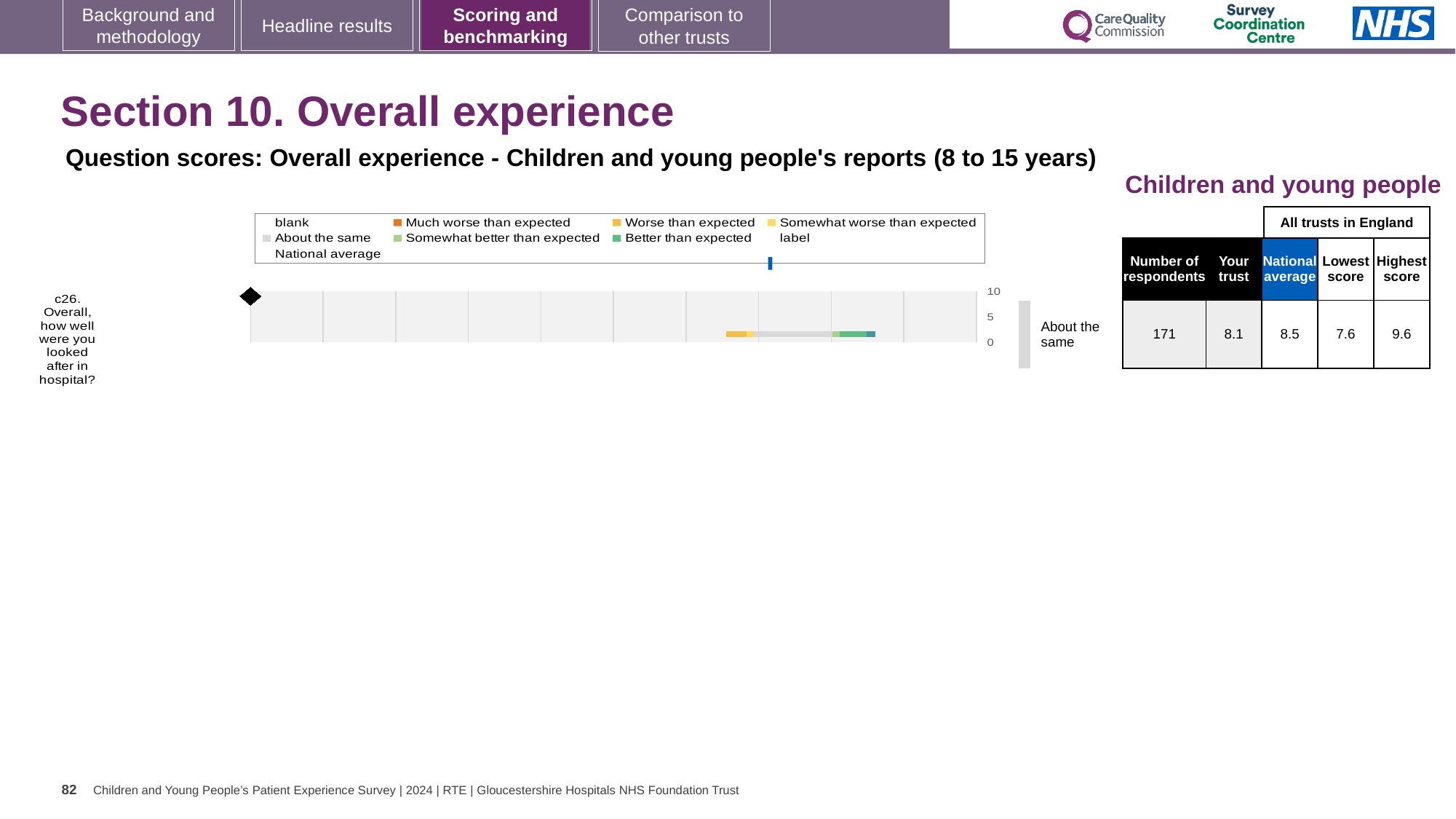
What is the lowest score among all trusts in England for question c26? 7.6 What is the national average score for question c26? 8.5 What is the maximum value shown on the chart's score axis? 10 What benchmark category is shown for question c26? About the same What is the 'Your trust' score for question c26? 8.1 How many respondents answered question c26? 171 What kind of chart is used to show the question score for c26? bar chart What is the difference between the highest score and the lowest score for question c26? 2.0 What is the highest score among all trusts in England for question c26? 9.6 How many questions are plotted in the chart? 1 Which is larger for question c26, the 'Your trust' score or the national average? National average Which question is plotted in the chart? c26. Overall, how well were you looked after in hospital?